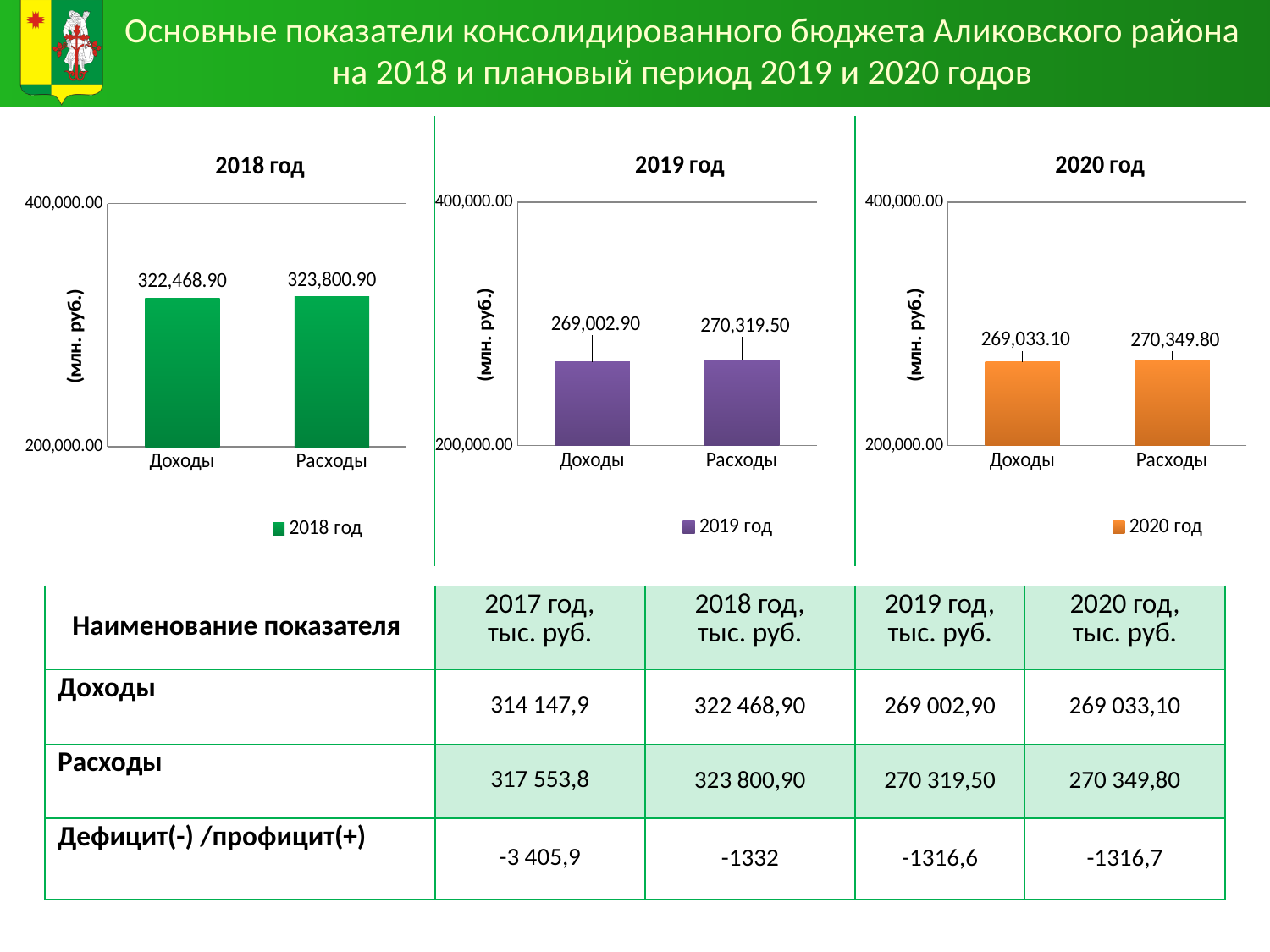
In the chart titled "2019 год", what is the value for Доходы? 269,002.90 In the chart titled "2019 год", what is the value for Расходы? 270,319.50 What is the y-axis label of the chart titled "2018 год"? (млн. руб.) In the chart titled "2018 год", what is the value for Доходы? 322,468.90 In the chart titled "2020 год", what is the value for Доходы? 269,033.10 In the chart titled "2018 год", what is the difference between Расходы and Доходы? 1,332.00 In the chart titled "2020 год", what is the value for Расходы? 270,349.80 What kind of chart is the chart titled "2019 год"? Bar chart In the chart titled "2020 год", which category has the lowest value? Доходы How many categories are shown in the chart titled "2020 год"? 2 In the chart titled "2019 год", which is larger, Доходы or Расходы? Расходы In the chart titled "2018 год", what is the value for Расходы? 323,800.90